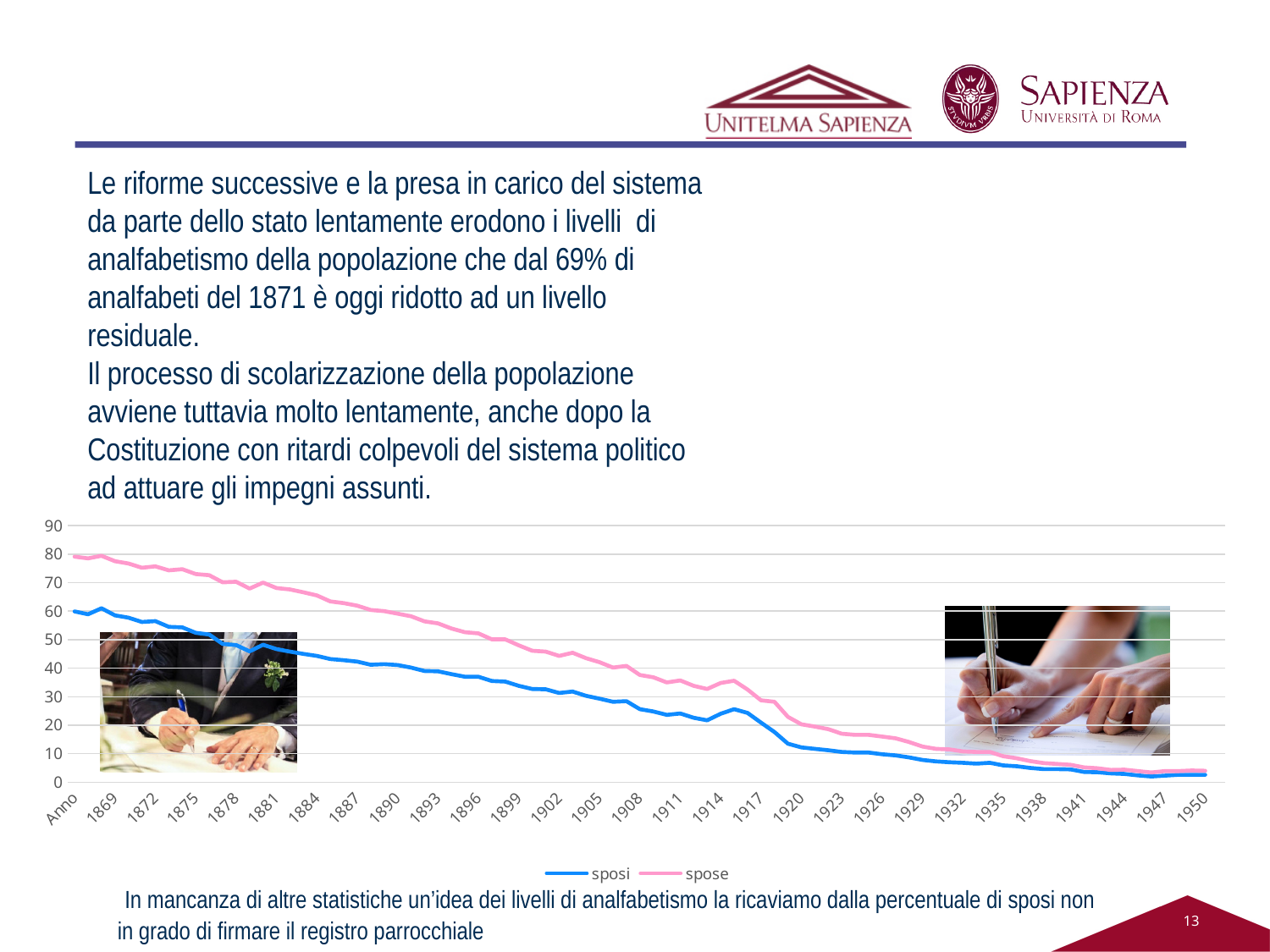
Which colour is used for the 'spose' line in the chart? pink Do the values of the 'sposi' series rise or fall from 1869 to 1950? fall Is the value for 'spose' in 1869 greater or less than 70? greater What are the two series named in the chart legend? sposi and spose In 1914, which series has the larger value, 'sposi' or 'spose'? spose Do the values of the 'spose' series rise or fall along the x axis? fall What kind of chart is shown on the slide? line chart Is the value for 'sposi' in 1941 greater or less than 10? less How many series does the chart legend list? 2 Is the value for 'spose' in 1950 greater or less than 10? less In 1869, which series has the larger value, 'sposi' or 'spose'? spose